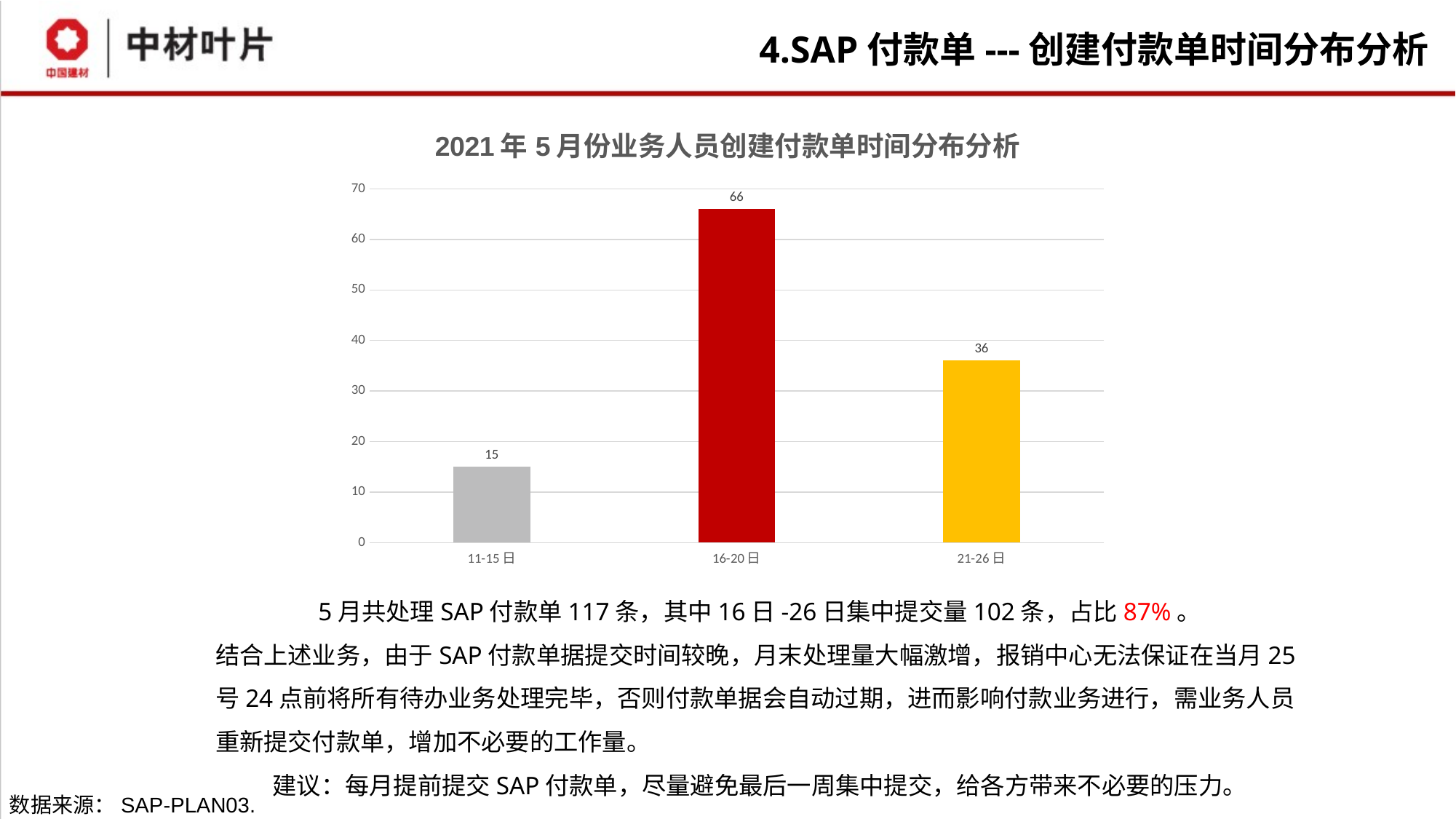
What is the difference between the values for 16-20 日 and 21-26 日? 30 What is the title of the chart? 2021 年 5 月份业务人员创建付款单时间分布分析 How many categories are shown on the x axis? 3 Which category has the lowest value? 11-15 日 Is the value for 16-20 日 greater or less than 60? greater Which category has the highest value? 16-20 日 What is the value for 21-26 日? 36 What kind of chart is shown on the slide? bar chart What is the value for 11-15 日? 15 Which is larger, the value for 11-15 日 or the value for 21-26 日? 21-26 日 What is the difference between the values for 21-26 日 and 11-15 日? 21 What is the value for 16-20 日? 66